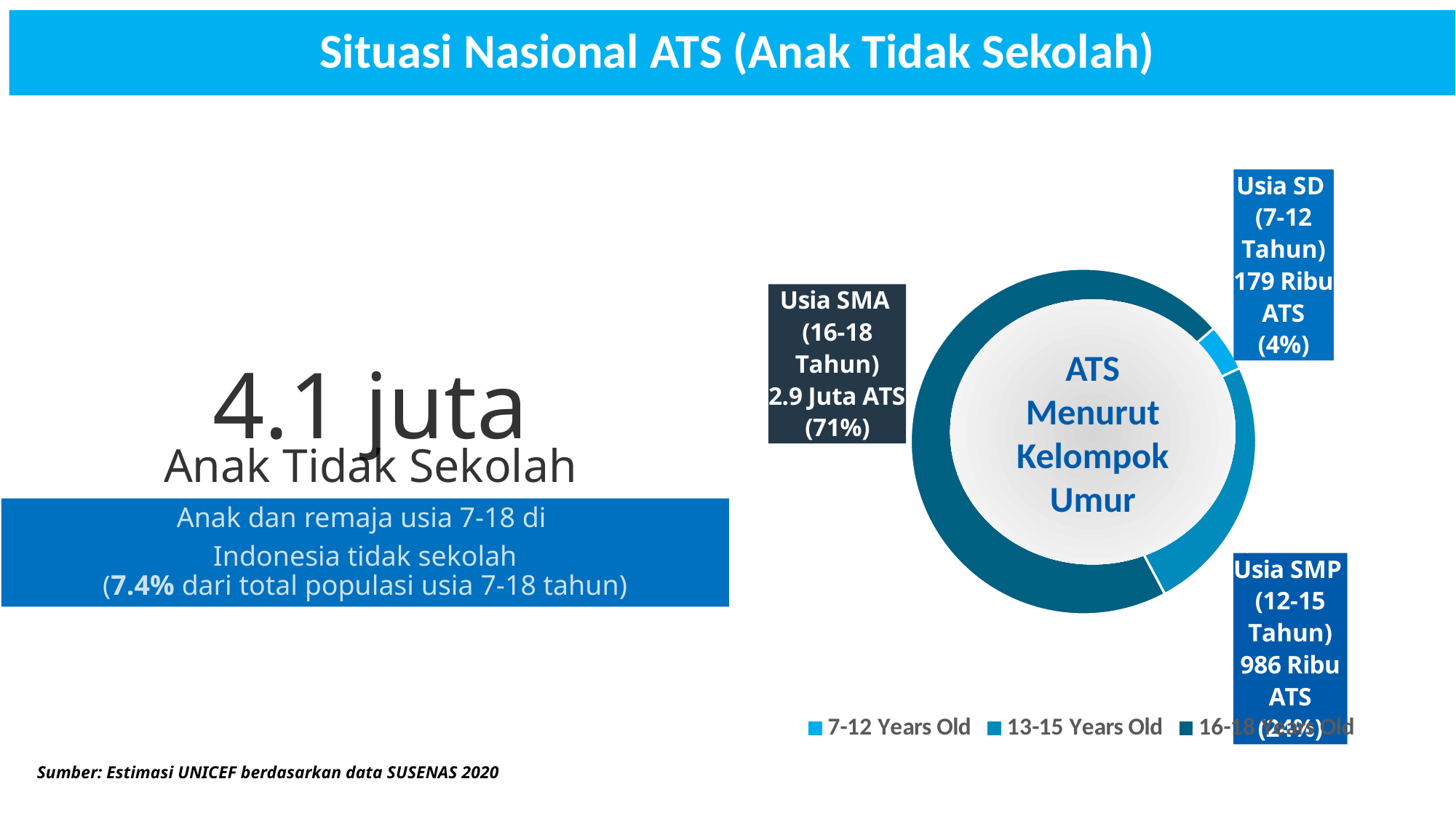
What is the difference in ATS between the Usia SMP (12-15 Tahun) group and the Usia SD (7-12 Tahun) group? 807 Ribu What share of ATS does the Usia SD (7-12 Tahun) group represent? 4% What is the title shown in the centre of the chart? ATS Menurut Kelompok Umur What kind of chart is shown on the slide? Doughnut (pie) chart Which age group has the smallest share of ATS? Usia SD (7-12 Tahun) How many age-group segments does the chart have? 3 How many ATS are in the Usia SMA (16-18 Tahun) group? 2.9 Juta ATS Which age group has the largest share of ATS? Usia SMA (16-18 Tahun) How many ATS are in the Usia SMP (12-15 Tahun) group? 986 Ribu ATS What share of ATS does the Usia SMA (16-18 Tahun) group represent? 71% How many entries does the chart's legend list? 3 How many ATS are in the Usia SD (7-12 Tahun) group? 179 Ribu ATS